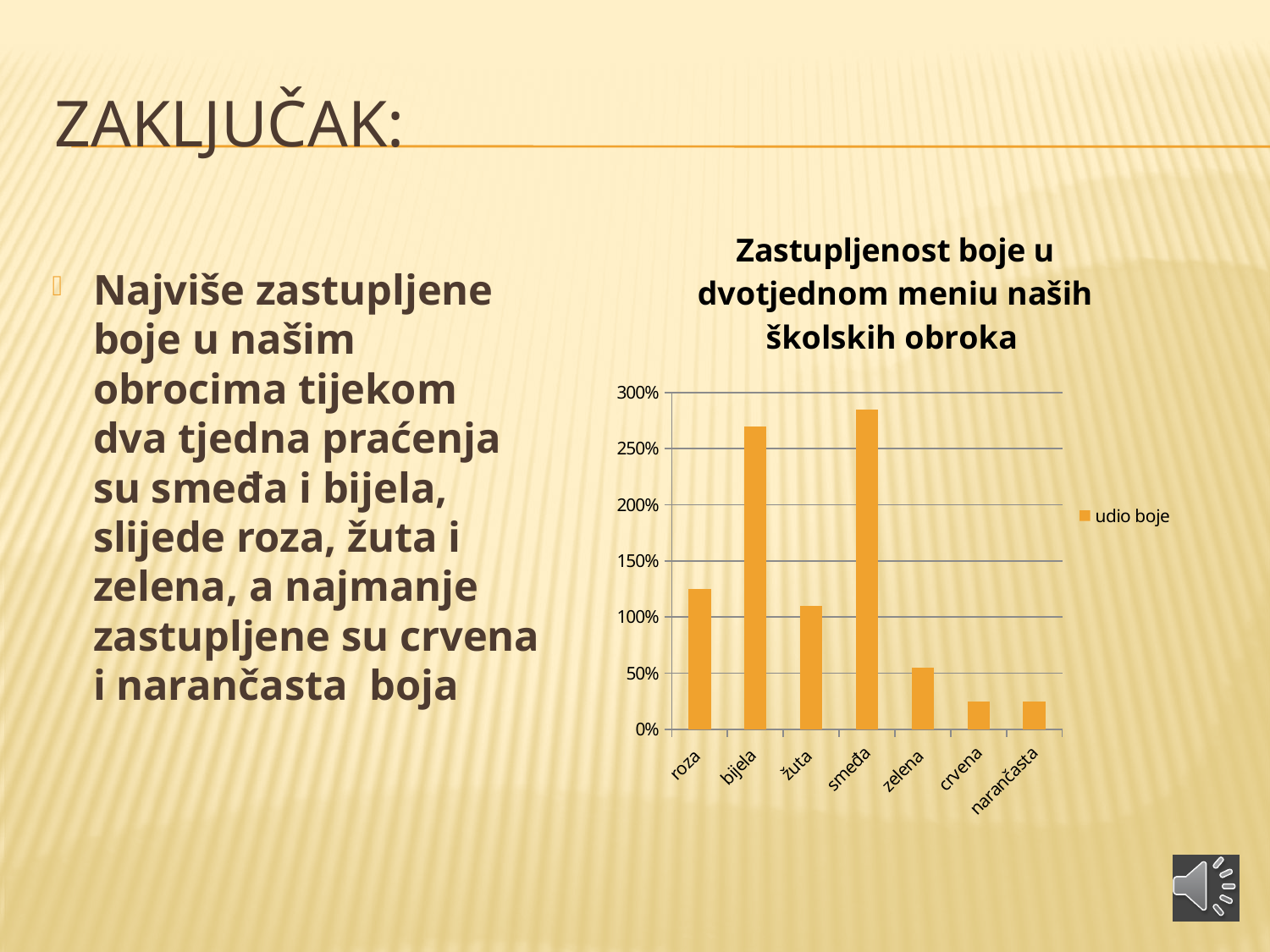
Is the value for roza greater or less than 100%? greater Which colour category has the highest bar? smeđa Is the value for crvena greater or less than 50%? less Is the value for bijela greater or less than 250%? greater Which is larger, the value for žuta or the value for zelena? žuta Which is larger, the value for bijela or the value for roza? bijela What is the name of the series shown in the legend? udio boje What kind of chart is shown on the slide? bar chart How many colour categories are plotted on the x axis? 7 What is the title of the chart? Zastupljenost boje u dvotjednom meniu naših školskih obroka How many series does the chart legend list? 1